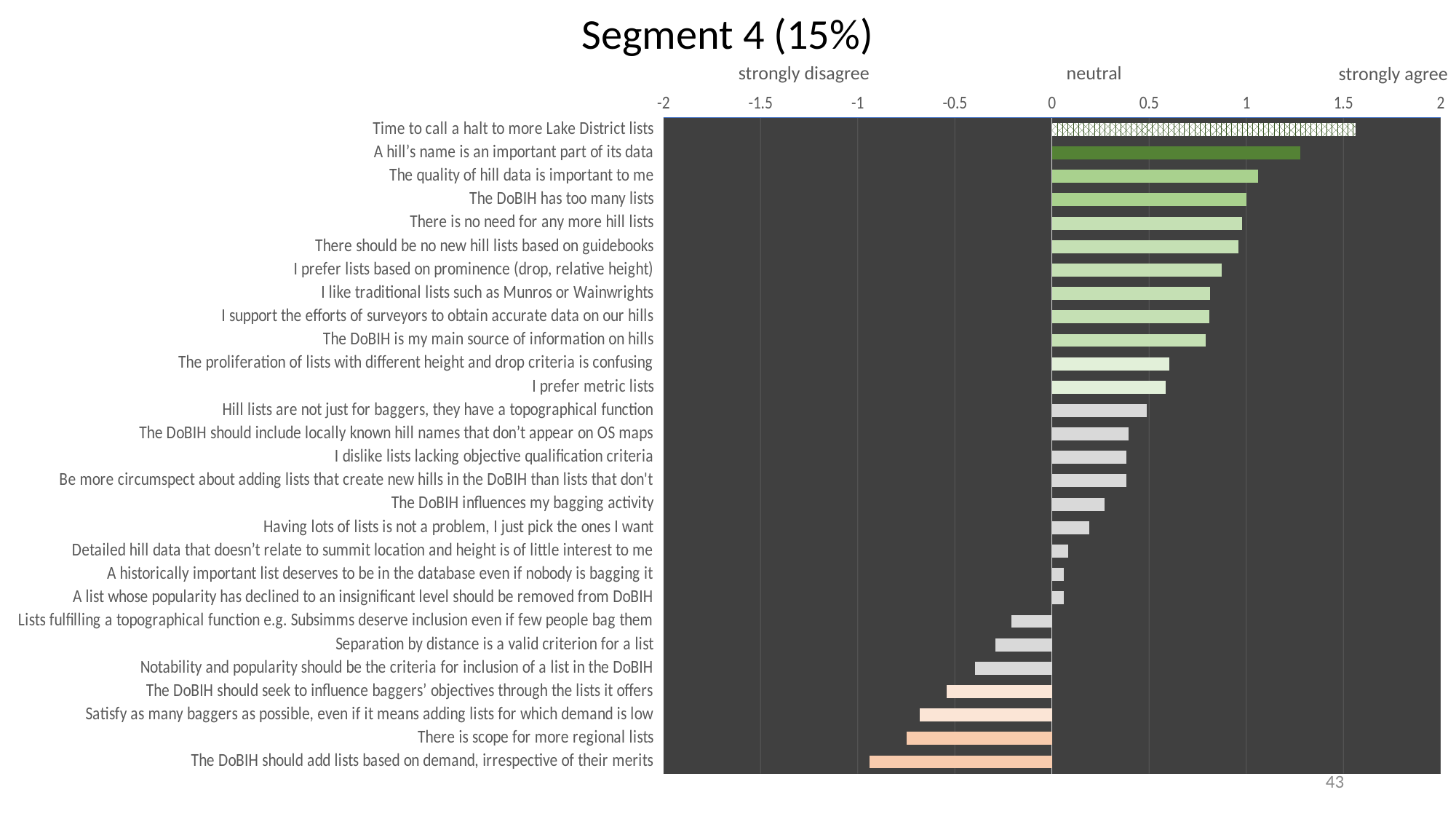
Is the value for "The DoBIH should add lists based on demand, irrespective of their merits" greater or less than -0.5? less What kind of chart is shown on the slide? bar chart Which has the larger value: "A hill's name is an important part of its data" or "The quality of hill data is important to me"? A hill's name is an important part of its data Is the value for "The DoBIH is my main source of information on hills" greater or less than 0.5? greater What label appears at the right end of the horizontal axis, above the value 2? strongly agree What is the title of the chart? Segment 4 (15%) Which statement has the lowest value in the chart? The DoBIH should add lists based on demand, irrespective of their merits Is the value for "A hill's name is an important part of its data" greater or less than 1? greater How many statements (categories) are plotted in the chart? 28 Which statement has the highest value in the chart? Time to call a halt to more Lake District lists